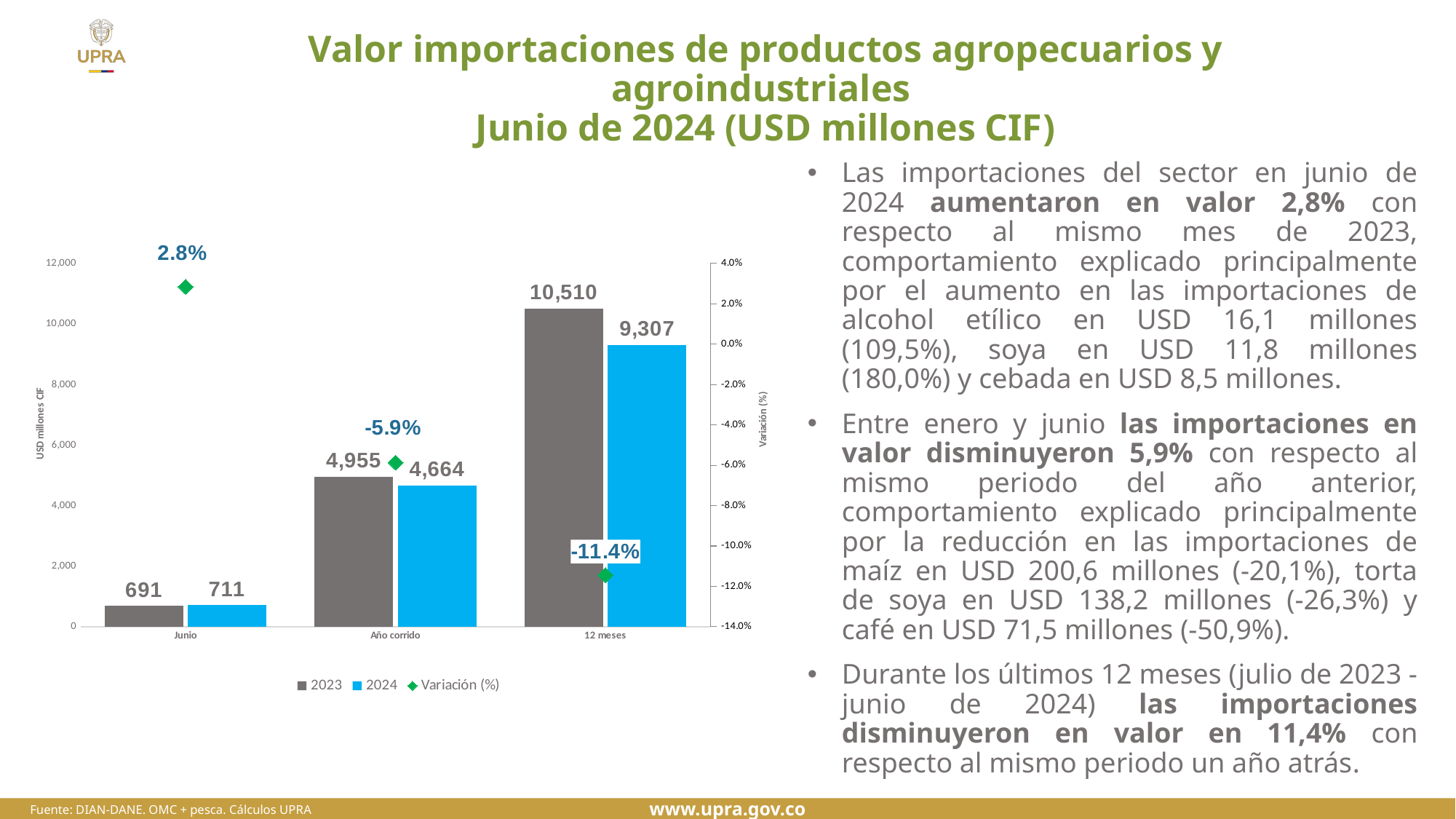
How many categories are shown on the x axis? 3 What is the label of the left vertical axis? USD millones CIF How many series does the legend list? 3 Which is larger for Junio, the 2023 value or the 2024 value? 2024 Which category has the highest 2023 value? 12 meses What is the difference between the 2023 and 2024 values for 12 meses? 1,203 Is the 2024 value for Año corrido greater or less than 6,000? less What is the 2024 value for 12 meses? 9,307 What is the Variación (%) value for Año corrido? -5.9% What is the 2023 value for Junio? 691 What kind of chart is used to show the 2023 and 2024 values? bar chart Which category has the lowest 2024 value? Junio